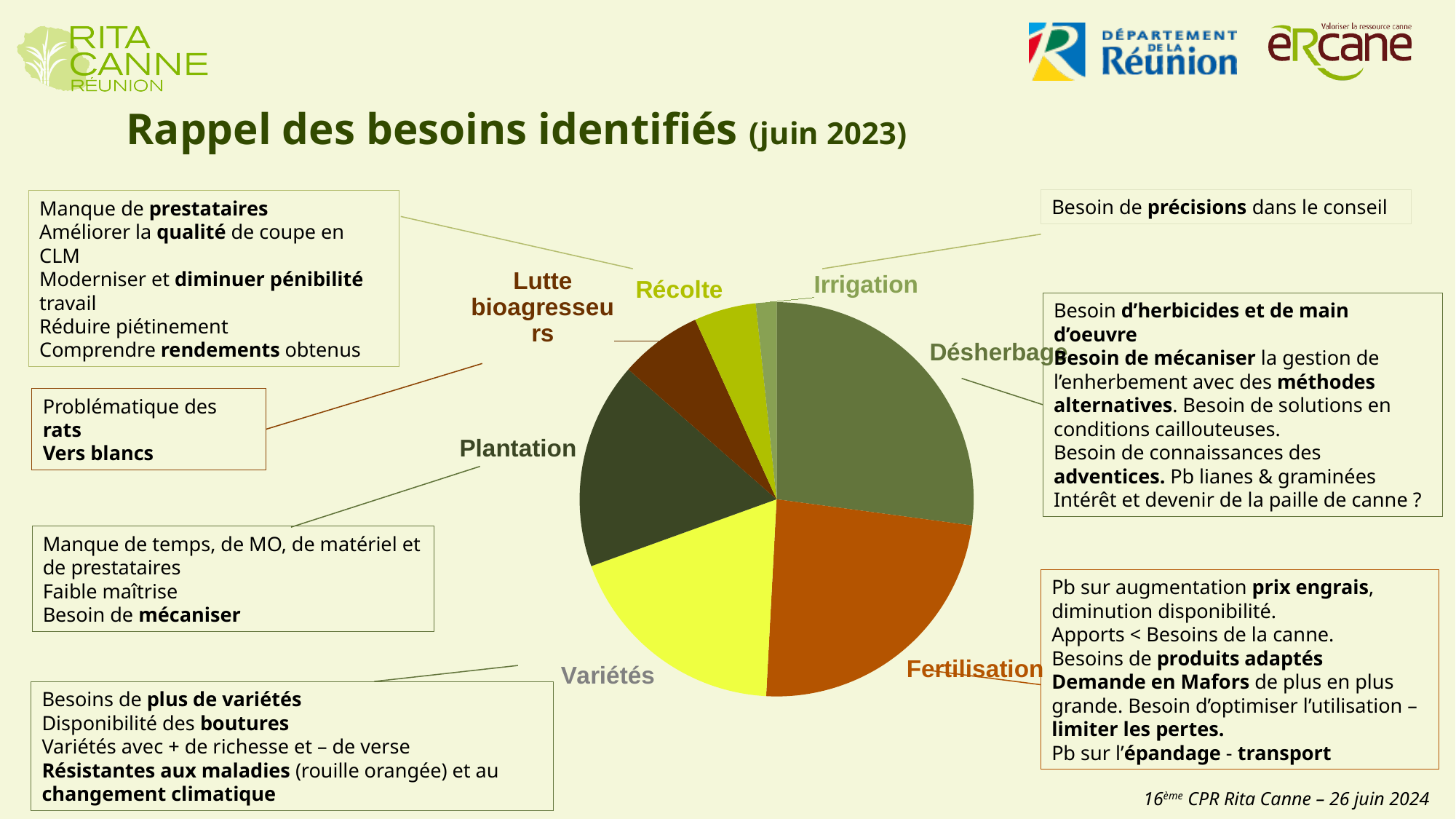
How many categories (slices) does the pie chart have? 7 Which slice is larger, Désherbage or Récolte? Désherbage Which slice is larger, Fertilisation or Irrigation? Fertilisation What is the title of the slide containing the pie chart? Rappel des besoins identifiés (juin 2023) Which category has the smallest slice of the pie chart? Irrigation Which slice is larger, Variétés or Récolte? Variétés What kind of chart is shown on the slide? Pie chart Which category of the pie chart is labelled in orange text? Fertilisation